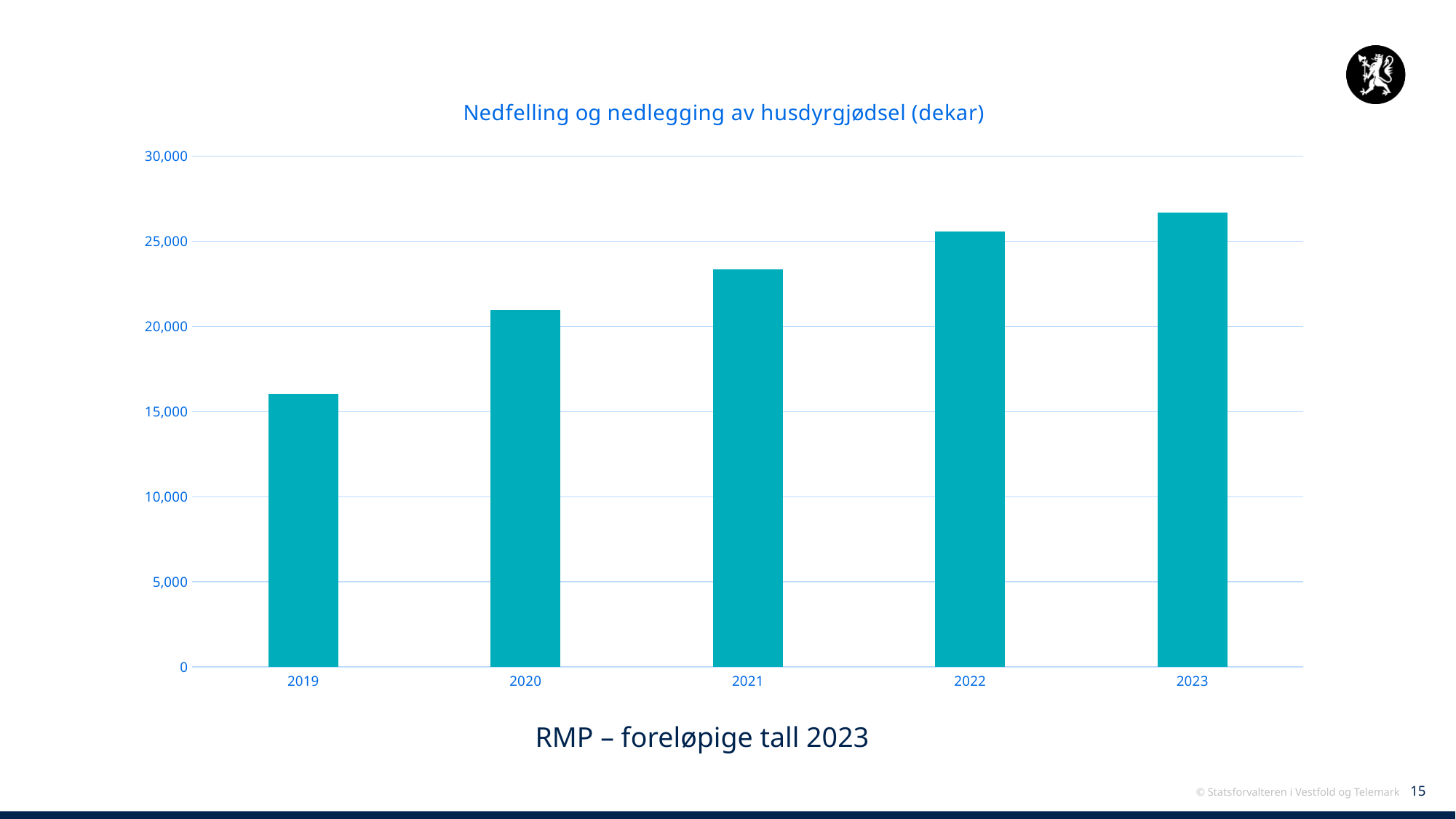
Do the values rise or fall from 2019 to 2023? rise What is the title of the chart? Nedfelling og nedlegging av husdyrgjødsel (dekar) Is the value for 2019 greater or less than 20,000? less Is the value for 2023 greater or less than 30,000? less Which is larger, the value for 2020 or the value for 2021? 2021 Which year has the highest value in the chart? 2023 Is the value for 2020 greater or less than 20,000? greater Which year has the lowest value in the chart? 2019 How many years are shown on the x axis of the chart? 5 What type of chart is shown on the slide? bar chart